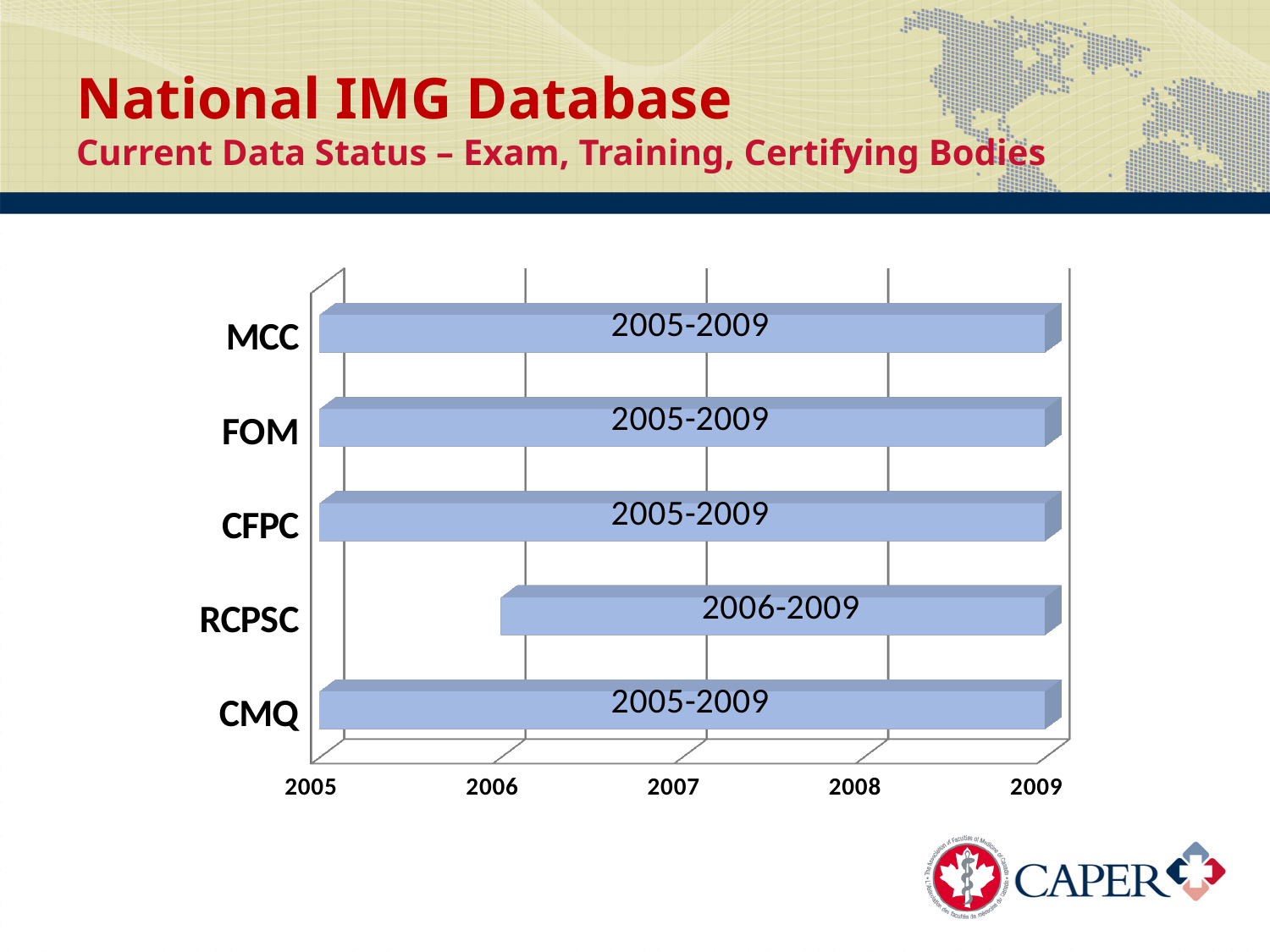
How many bodies have data covering 2005-2009? 4 What data range is shown on the bar for CFPC? 2005-2009 Which body's data starts in 2006 rather than 2005? RCPSC Which body has the shortest bar on the chart? RCPSC What is the first year shown on the x axis? 2005 What is the last year shown on the x axis? 2009 What data range is shown on the bar for CMQ? 2005-2009 What data range is shown on the bar for RCPSC? 2006-2009 Is the bar for FOM longer or shorter than the bar for RCPSC? Longer What data range is shown on the bar for MCC? 2005-2009 What kind of chart is shown on the slide? Bar chart How many bodies are listed on the chart? 5